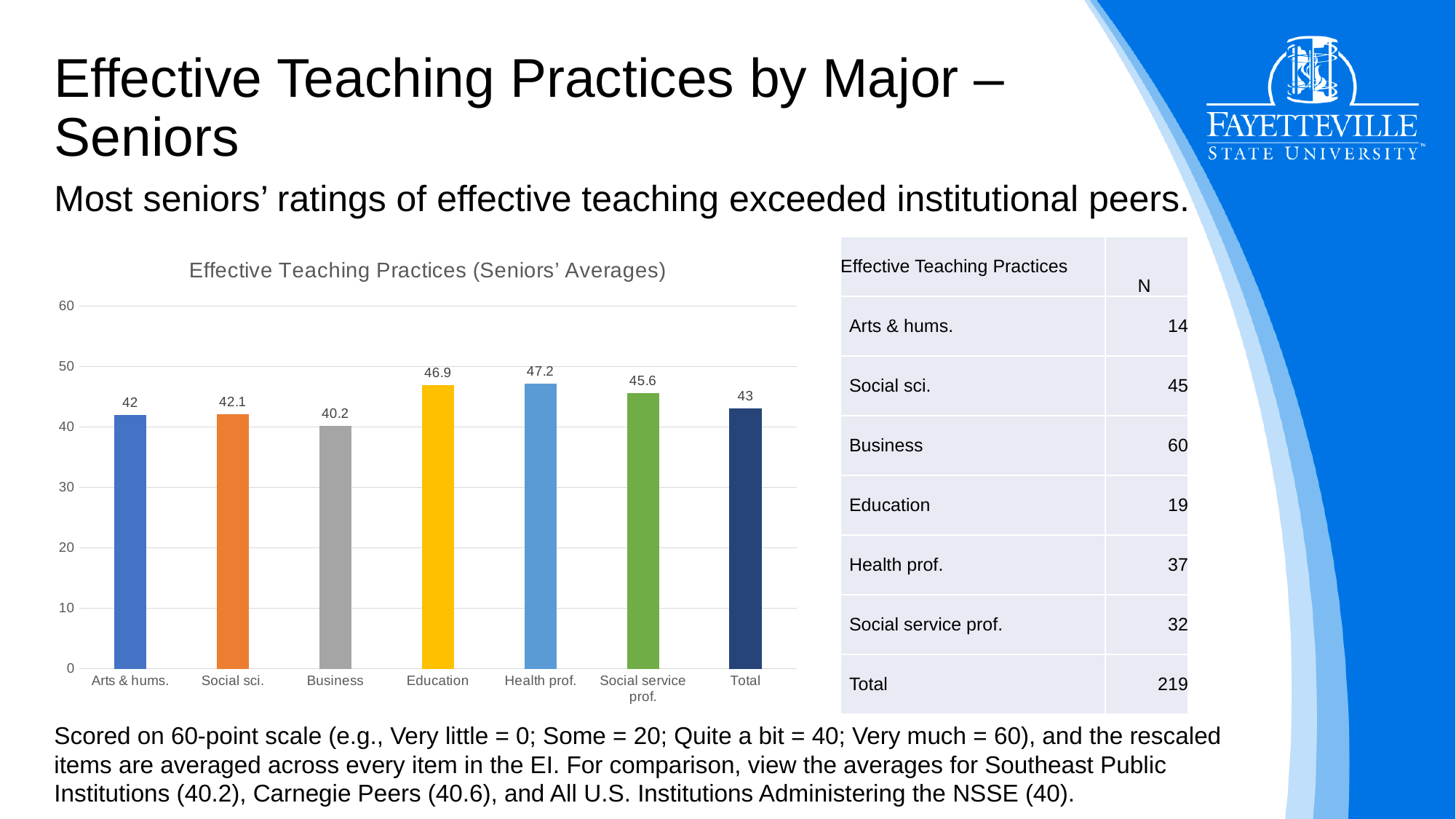
What kind of chart is shown on the slide? bar chart What is the title of the chart? Effective Teaching Practices (Seniors' Averages) Is the value for Health prof. greater or less than 50? less What is the value for Education in the Effective Teaching Practices (Seniors' Averages) chart? 46.9 What is the difference between the values for Education and Social sci.? 4.8 Which category has the lowest value in the chart? Business What is the difference between the values for Health prof. and Business? 7 Which is larger, the value for Social service prof. or the value for Arts & hums.? Social service prof. Which category has the highest value in the chart? Health prof. What is the value for Total in the chart? 43 What is the value for Business in the chart? 40.2 How many categories are shown on the x axis of the chart? 7